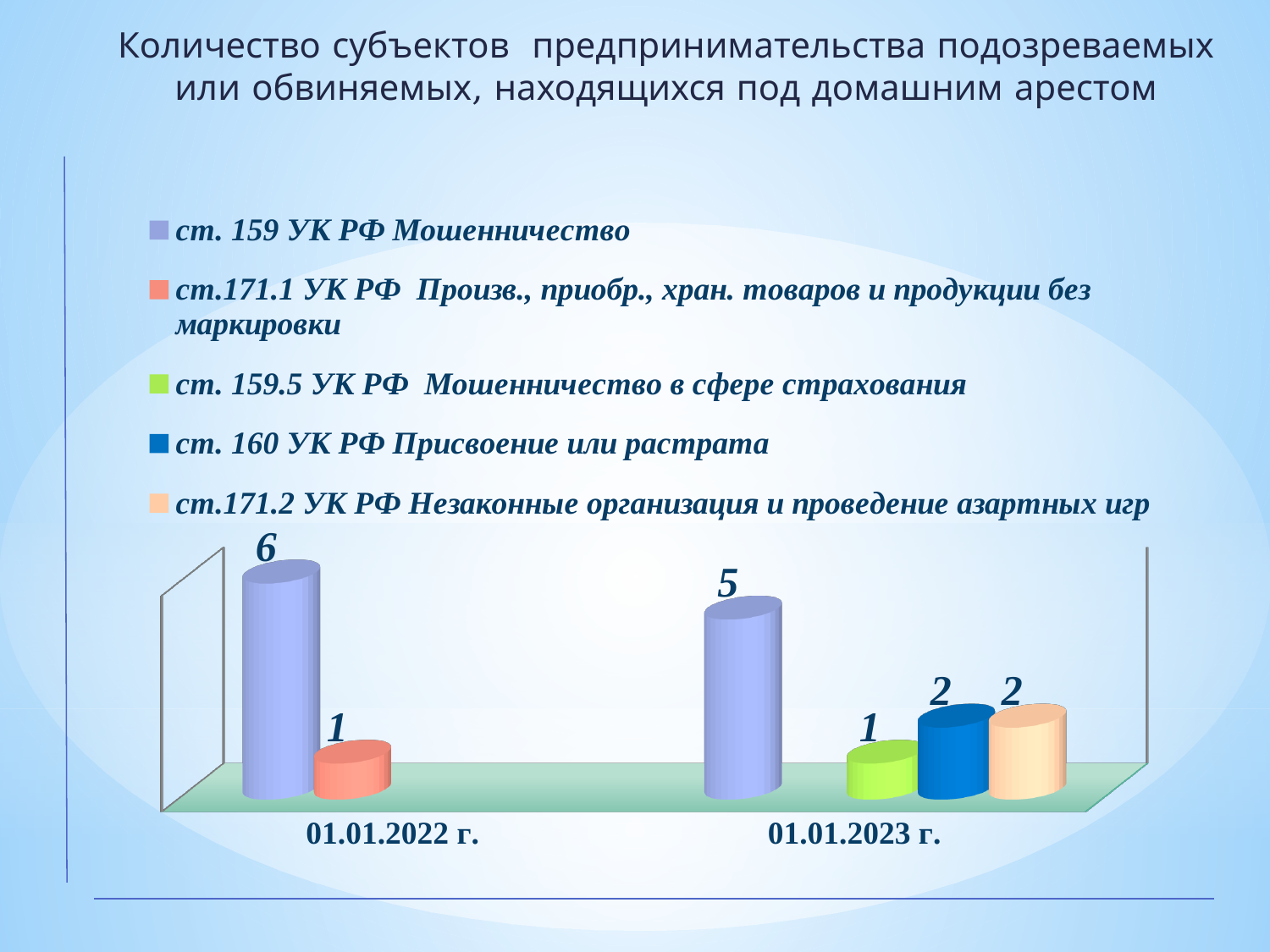
How many date categories are shown on the x axis? 2 What is the value for ст. 159 УК РФ Мошенничество on 01.01.2023 г.? 5 What is the value for ст.171.1 УК РФ (товаров и продукции без маркировки) on 01.01.2022 г.? 1 What is the value for ст. 159 УК РФ Мошенничество on 01.01.2022 г.? 6 What is the value for ст.171.2 УК РФ Незаконные организация и проведение азартных игр on 01.01.2023 г.? 2 Which series has the highest value on 01.01.2023 г.? ст. 159 УК РФ Мошенничество What is the difference between the ст. 159 УК РФ Мошенничество values on 01.01.2022 г. and 01.01.2023 г.? 1 What is the value for ст. 160 УК РФ Присвоение или растрата on 01.01.2023 г.? 2 What kind of chart is shown on the slide? Bar chart Which is larger: ст. 160 УК РФ on 01.01.2023 г. or ст. 159.5 УК РФ on 01.01.2023 г.? ст. 160 УК РФ What is the value for ст. 159.5 УК РФ Мошенничество в сфере страхования on 01.01.2023 г.? 1 How many series does the legend list? 5